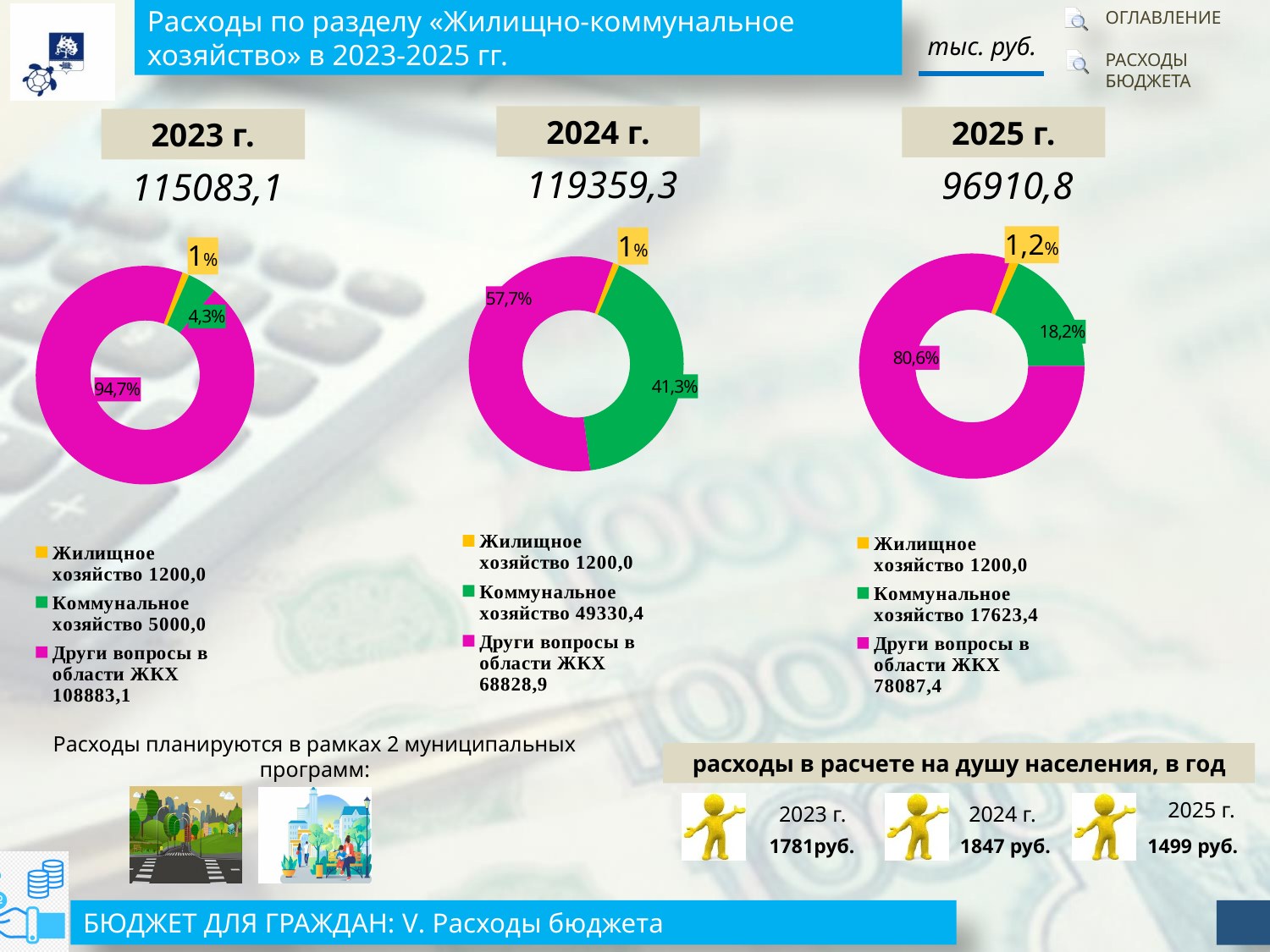
In the 2023 г. chart, what is the value for Коммунальное хозяйство? 5000,0 In the 2025 г. chart, what percentage is shown for Жилищное хозяйство? 1,2% In the 2023 г. chart, what percentage is shown for Коммунальное хозяйство? 4,3% In the 2025 г. chart, what is the value for Други вопросы в области ЖКХ? 78087,4 How many categories does the 2023 г. chart show? 3 In the 2024 г. chart, which category has the smallest share? Жилищное хозяйство In the 2025 г. chart, what is the difference between Коммунальное хозяйство and Жилищное хозяйство? 16423,4 In the 2024 г. chart, what share of the donut does Коммунальное хозяйство take? 41,3% What type of chart is used for 2024 г.? Donut (pie) chart What colour represents Жилищное хозяйство in the 2025 г. chart? Yellow In the 2024 г. chart, which is larger: Коммунальное хозяйство or Други вопросы в области ЖКХ? Други вопросы в области ЖКХ In the 2023 г. chart, which category has the largest share? Други вопросы в области ЖКХ